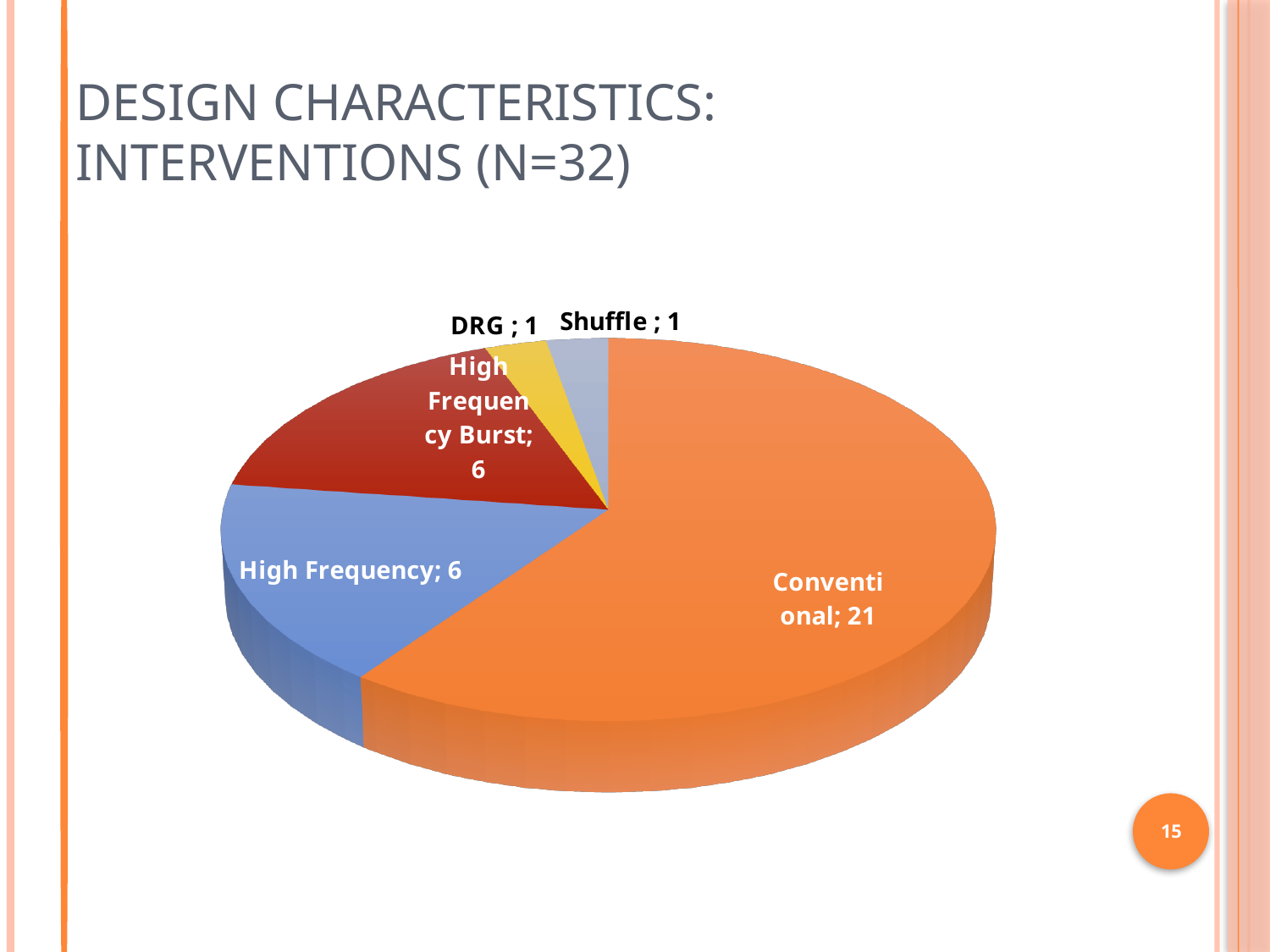
What is the value shown for the High Frequency Burst slice? 6 Which is larger, the Conventional slice or the High Frequency Burst slice? Conventional Which categories have the smallest value in the pie chart? DRG and Shuffle What is the value shown for the Shuffle slice? 1 Which category has the largest slice in the pie chart? Conventional What kind of chart is shown on the slide? Pie chart How many slices does the pie chart have? 5 What is the value shown for the Conventional slice? 21 What is the value shown for the High Frequency slice? 6 What is the value shown for the DRG slice? 1 What is the difference between the Conventional value and the High Frequency value? 15 What colour is the Conventional slice? Orange